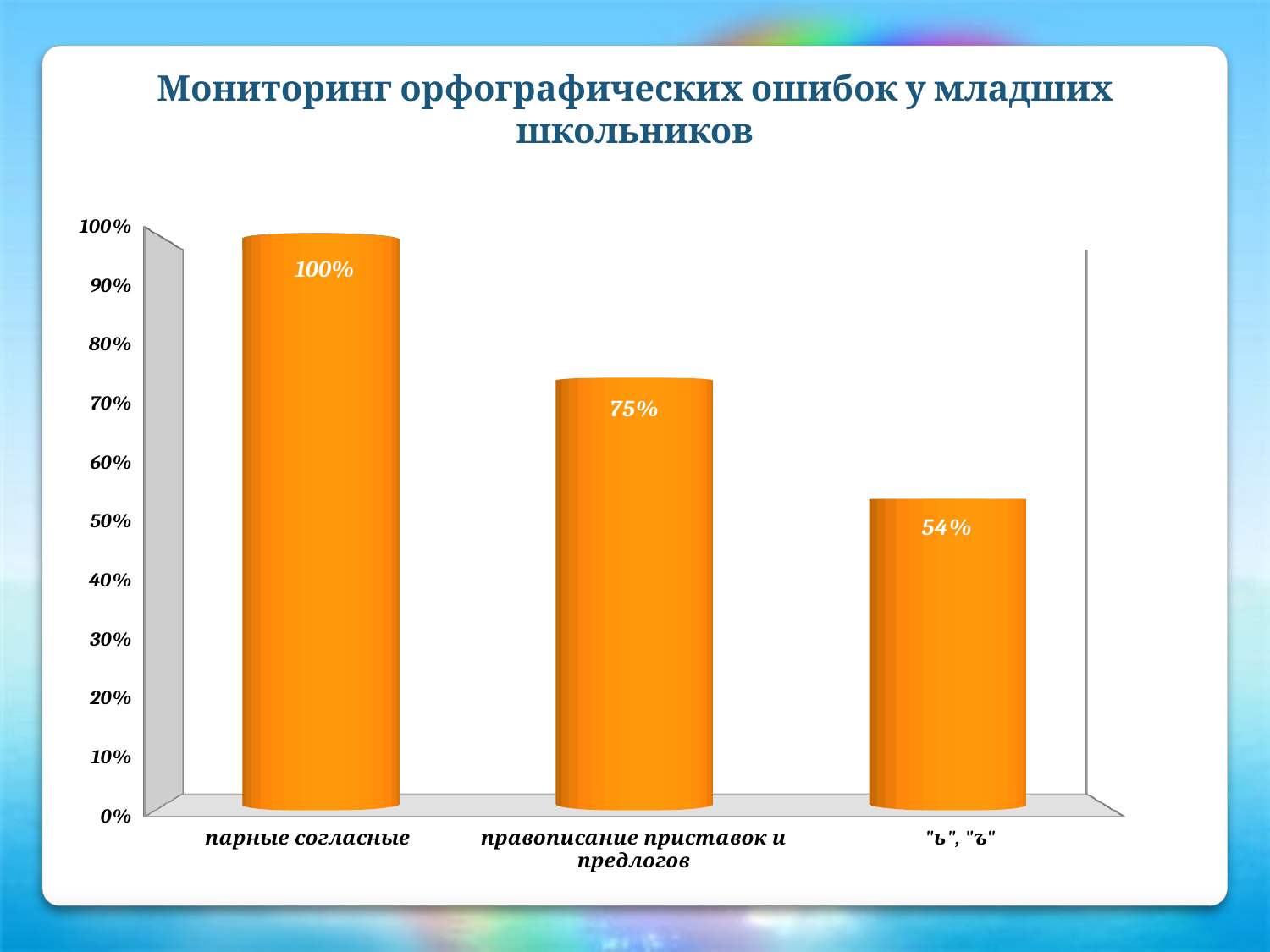
What is the value for парные согласные? 100% What is the difference between the values for правописание приставок и предлогов and "ь", "ъ"? 21% What is the value for правописание приставок и предлогов? 75% Which category has the lowest value? "ь", "ъ" Do the values rise or fall from left to right along the x axis? fall Which category has the highest value? парные согласные How many categories are shown on the chart? 3 What kind of chart is shown on the slide? bar chart What is the difference between the values for парные согласные and правописание приставок и предлогов? 25% Which is larger, the value for правописание приставок и предлогов or the value for "ь", "ъ"? правописание приставок и предлогов Is the value for "ь", "ъ" greater or less than 60%? less What is the value for "ь", "ъ"? 54%